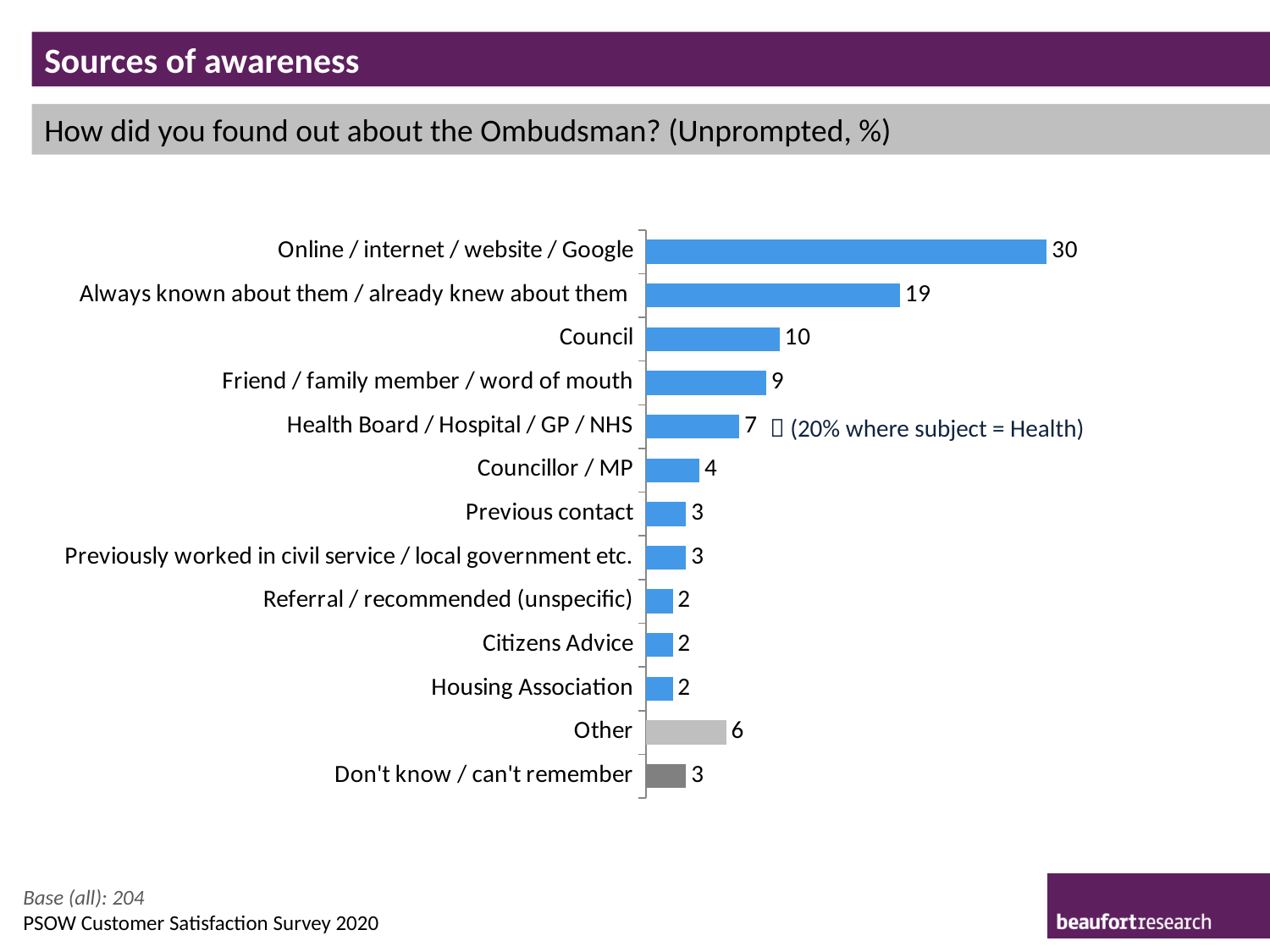
What is the value for Council? 10 What kind of chart is shown on the slide? Bar chart What is the difference between the values for Online / internet / website / Google and Always known about them / already knew about them? 11 Which category has the highest value? Online / internet / website / Google What is the difference between the values for Councillor / MP and Previous contact? 1 What is the value for Online / internet / website / Google? 30 What is the value for Don't know / can't remember? 3 Which is larger, the value for Council or the value for Friend / family member / word of mouth? Council What is the base (number of respondents) stated on the slide? 204 What is the value for Health Board / Hospital / GP / NHS? 7 How many categories are shown in the chart? 13 What is the value for Other? 6